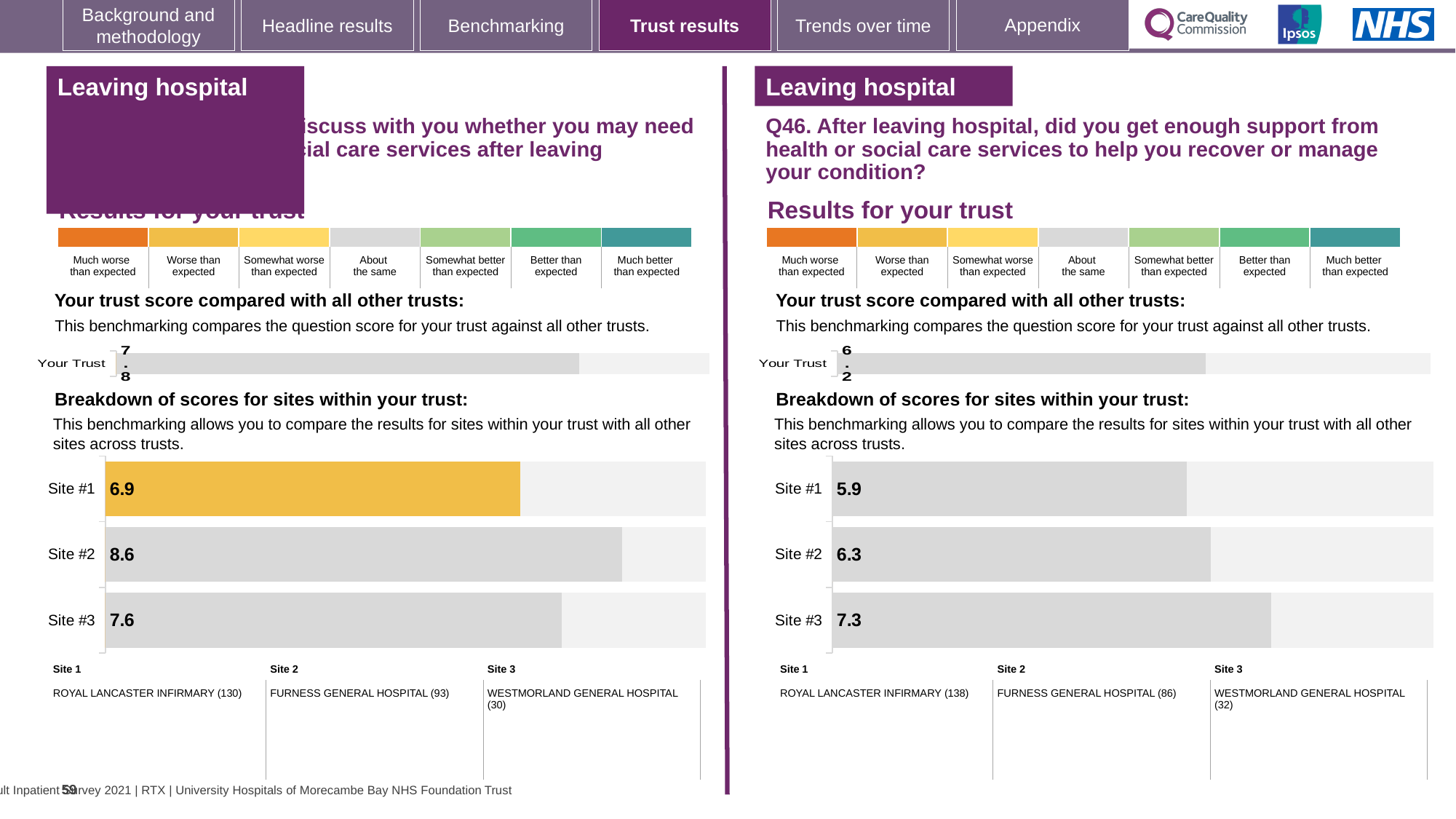
In the left-hand site breakdown chart, what is the score for Site #1? 6.9 In the Q46 site breakdown chart on the right, what is the difference between the scores for Site #3 and Site #2? 1.0 How many sites are shown in the left-hand site breakdown chart? 3 What kind of chart is used for the site breakdown on the right-hand side of the slide? Bar chart In the left-hand site breakdown chart, what is the score for Site #2? 8.6 In the left-hand site breakdown chart, which site has the highest score? Site #2 In the Q46 site breakdown chart on the right, what is the score for Site #3? 7.3 In the left-hand site breakdown chart, what is the difference between the scores for Site #2 and Site #1? 1.7 In the Q46 site breakdown chart on the right, which site has the lowest score? Site #1 In the Q46 site breakdown chart on the right, what is the score for Site #1? 5.9 In the Q46 site breakdown chart on the right, which has the larger score, Site #2 or Site #3? Site #3 In the left-hand site breakdown chart, which site's bar is coloured yellow rather than grey? Site #1